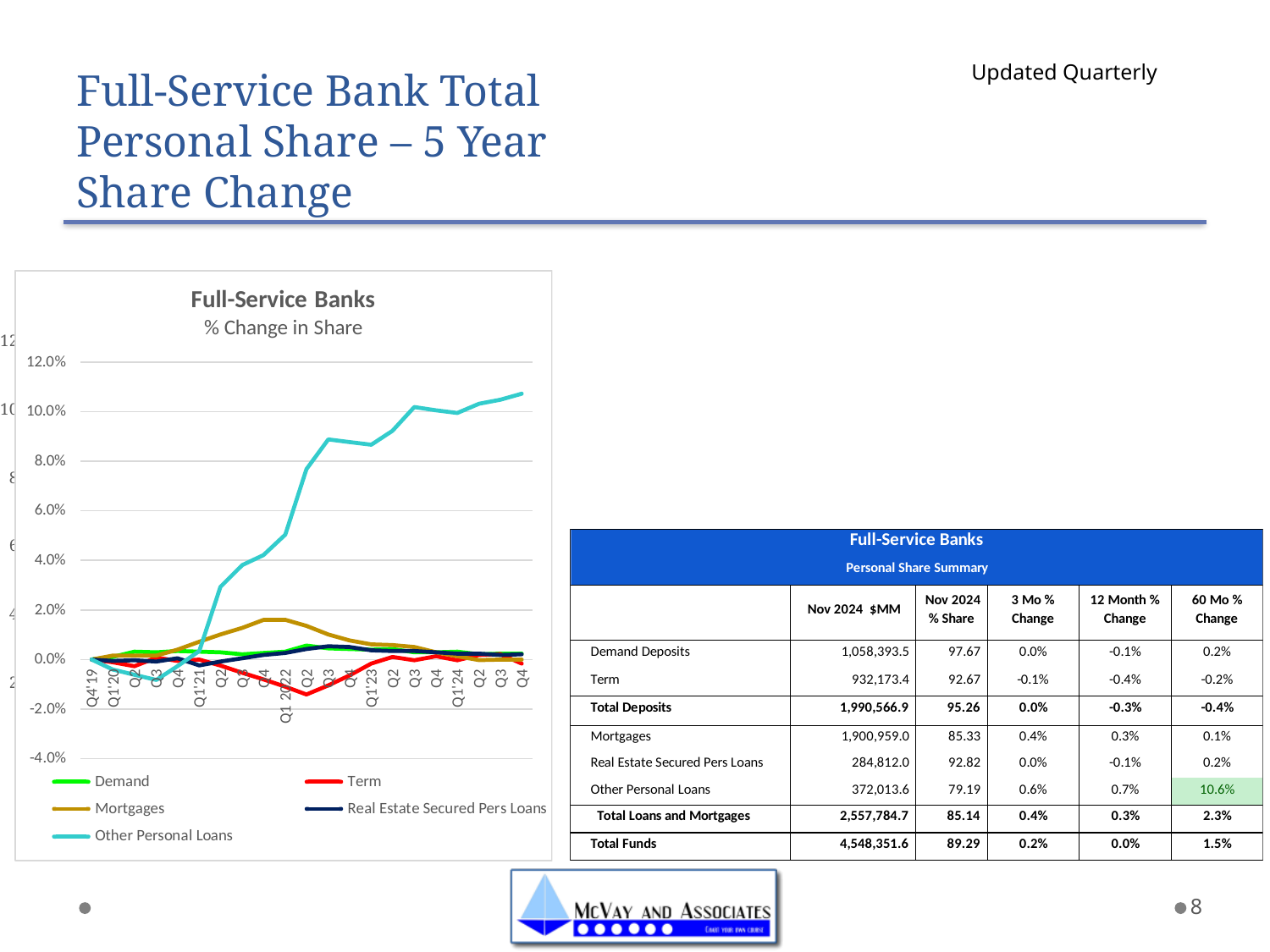
Is the lowest value of the Term series greater or less than 0.0%? less Is the value for Other Personal Loans at Q4'24 greater or less than 10.0%? greater Which series reaches the highest value on the chart? Other Personal Loans Which series drops to the lowest value on the chart? Term Is the value for Other Personal Loans at Q1'23 greater or less than 8.0%? greater What is the title of the chart? Full-Service Banks % Change in Share What kind of chart is shown on the slide? line chart Which series is drawn in red on the chart? Term How many series does the legend of the chart list? 5 Does the Other Personal Loans series generally rise or fall from Q4'19 to Q4'24? rise At Q4'24, which is larger: Other Personal Loans or Demand? Other Personal Loans